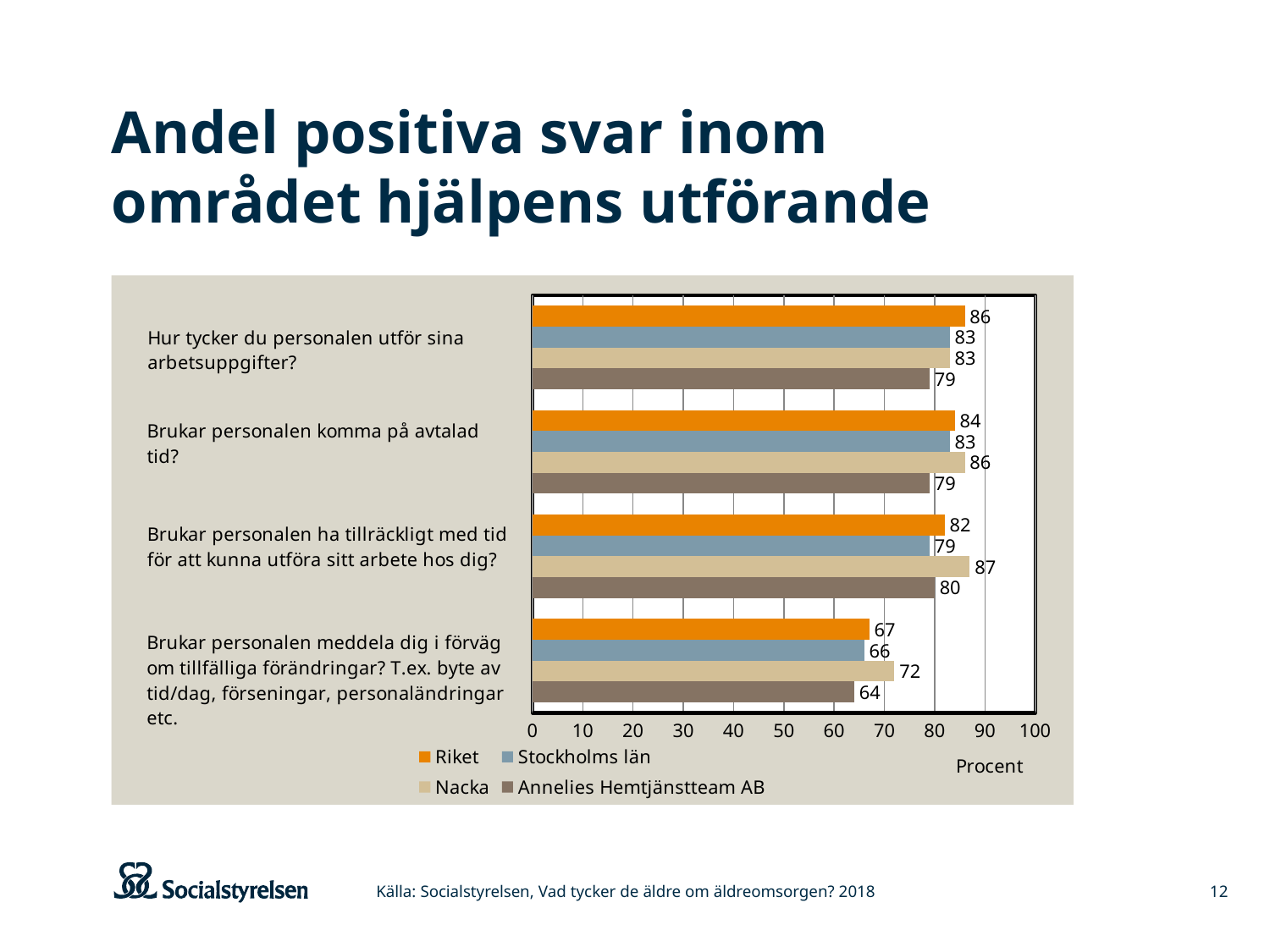
For "Brukar personalen komma på avtalad tid?", which is larger: Riket or Nacka? Nacka What unit is shown on the x axis of the chart? Procent How many series does the legend list? 4 How many question categories are plotted in the chart? 4 What is the value for Stockholms län for "Brukar personalen meddela dig i förväg om tillfälliga förändringar?"? 66 What is the difference between Nacka and Annelies Hemtjänstteam AB for "Brukar personalen meddela dig i förväg om tillfälliga förändringar?"? 8 Which series has the highest value for "Brukar personalen ha tillräckligt med tid för att kunna utföra sitt arbete hos dig?"? Nacka What is the value for Annelies Hemtjänstteam AB for "Brukar personalen komma på avtalad tid?"? 79 Which series has the lowest value for "Brukar personalen meddela dig i förväg om tillfälliga förändringar?"? Annelies Hemtjänstteam AB What kind of chart is shown on the slide? Bar chart What is the value for Riket for "Hur tycker du personalen utför sina arbetsuppgifter?"? 86 What is the value for Nacka for "Brukar personalen ha tillräckligt med tid för att kunna utföra sitt arbete hos dig?"? 87